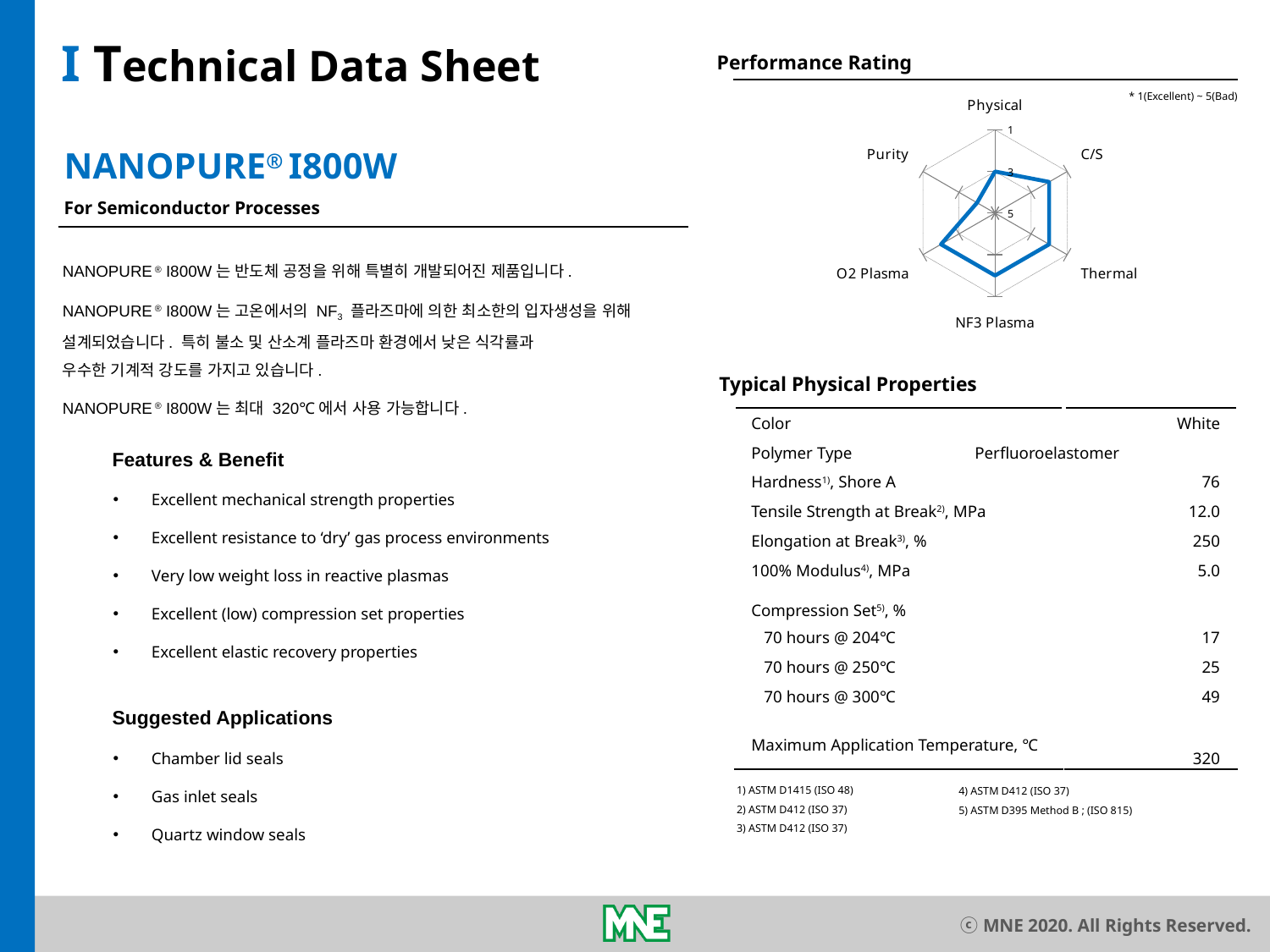
According to the note on the Performance Rating chart, what rating value means Excellent? 1 What is the title of the chart on the slide? Performance Rating In the Performance Rating chart, which has the better (lower) rating, Purity or Thermal? Thermal In the Performance Rating chart, is the rating for NF3 Plasma greater or less than 3? less In the Performance Rating chart, is the rating for Thermal greater or less than 3? less Which category label sits at the top of the Performance Rating radar chart? Physical In the Performance Rating chart, is the rating for Purity greater or less than 3? greater How many categories (axes) does the Performance Rating radar chart have? 6 How many data series are plotted on the Performance Rating chart? 1 In the Performance Rating chart, which category has the worst (highest-numbered) rating? Purity What kind of chart is shown under the Performance Rating heading? Radar chart